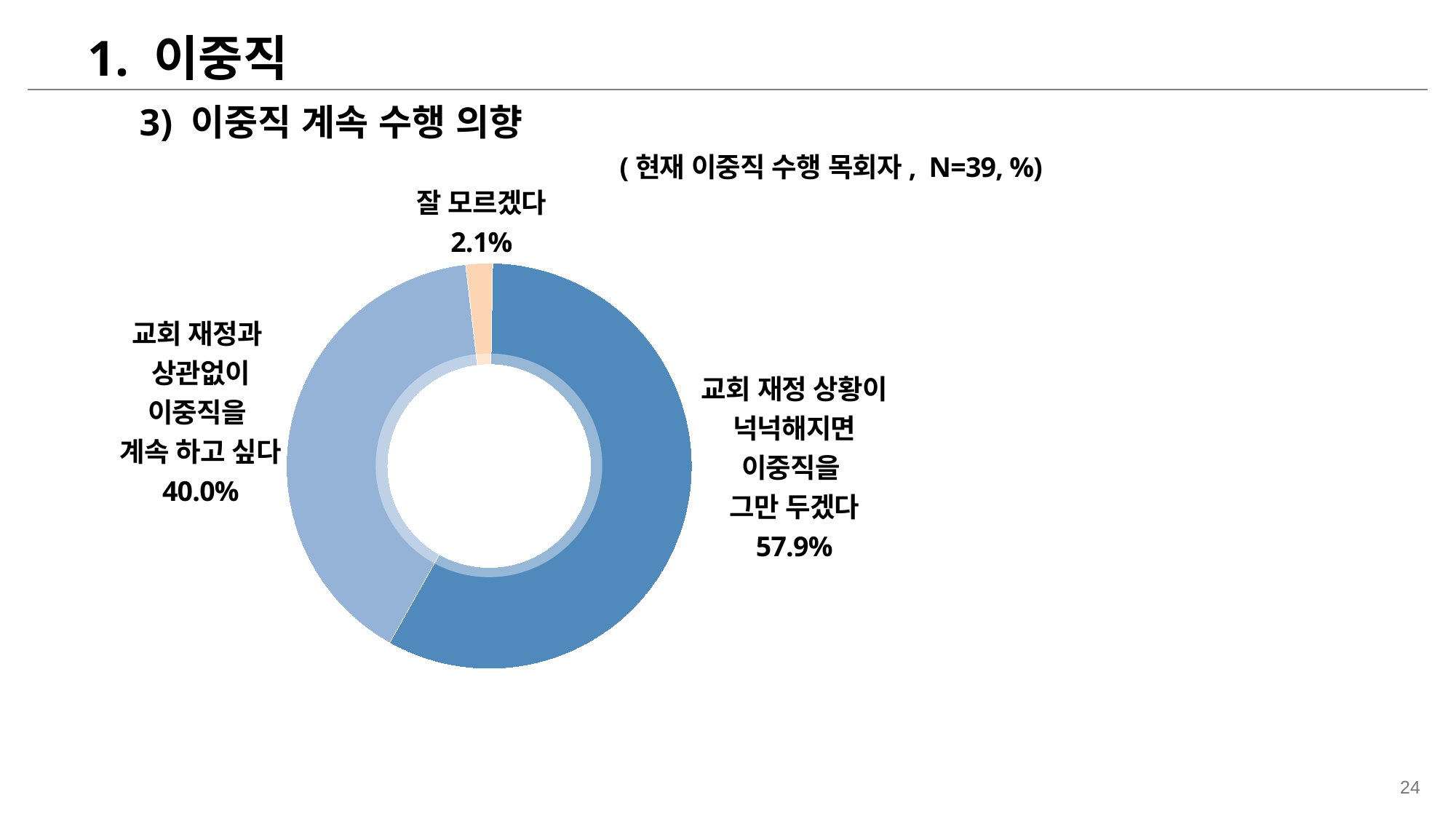
Is the share for '교회 재정 상황이 넉넉해지면 이중직을 그만 두겠다' greater or less than 50%? greater Which is larger: the share for '교회 재정과 상관없이 이중직을 계속 하고 싶다' or the share for '잘 모르겠다'? 교회 재정과 상관없이 이중직을 계속 하고 싶다 How many categories are shown in the chart? 3 Which response has the smallest share of the chart? 잘 모르겠다 Which response has the largest share of the chart? 교회 재정 상황이 넉넉해지면 이중직을 그만 두겠다 What percentage of respondents chose '교회 재정 상황이 넉넉해지면 이중직을 그만 두겠다'? 57.9% What is the sample size (N) stated for the chart? 39 What percentage of respondents answered '잘 모르겠다'? 2.1% What kind of chart is shown on the slide? Doughnut (pie) chart What percentage of respondents chose '교회 재정과 상관없이 이중직을 계속 하고 싶다'? 40.0% What is the difference in percentage points between '교회 재정 상황이 넉넉해지면 이중직을 그만 두겠다' and '교회 재정과 상관없이 이중직을 계속 하고 싶다'? 17.9 percentage points What is the title of the chart section on the slide? 3) 이중직 계속 수행 의향